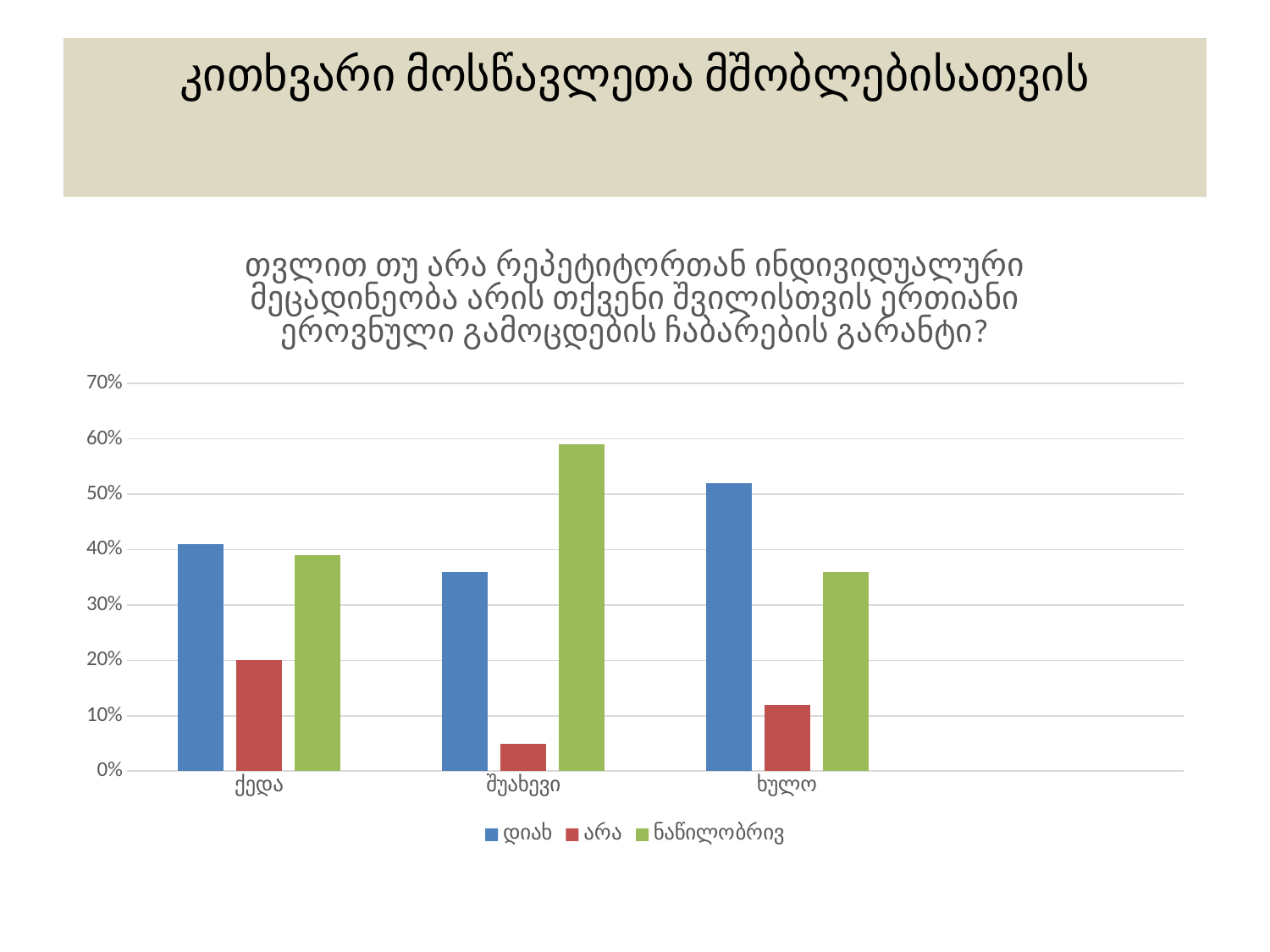
What colour are the bars for the არა series? red How many categories are shown on the x axis of the chart? 3 Is the value for ნაწილობრივ in შუახევი greater or less than 50%? greater What kind of chart is shown on the slide? bar chart Which category has the highest value for the დიახ series? ხულო Which is larger in ხულო: the value for დიახ or the value for ნაწილობრივ? დიახ Which is larger in შუახევი: the value for დიახ or the value for ნაწილობრივ? ნაწილობრივ How many series does the chart legend list? 3 Is the value for დიახ in ხულო greater or less than 50%? greater Which category has the lowest value for the არა series? შუახევი Is the value for არა in ქედა greater or less than 30%? less Which category has the highest value for the ნაწილობრივ series? შუახევი